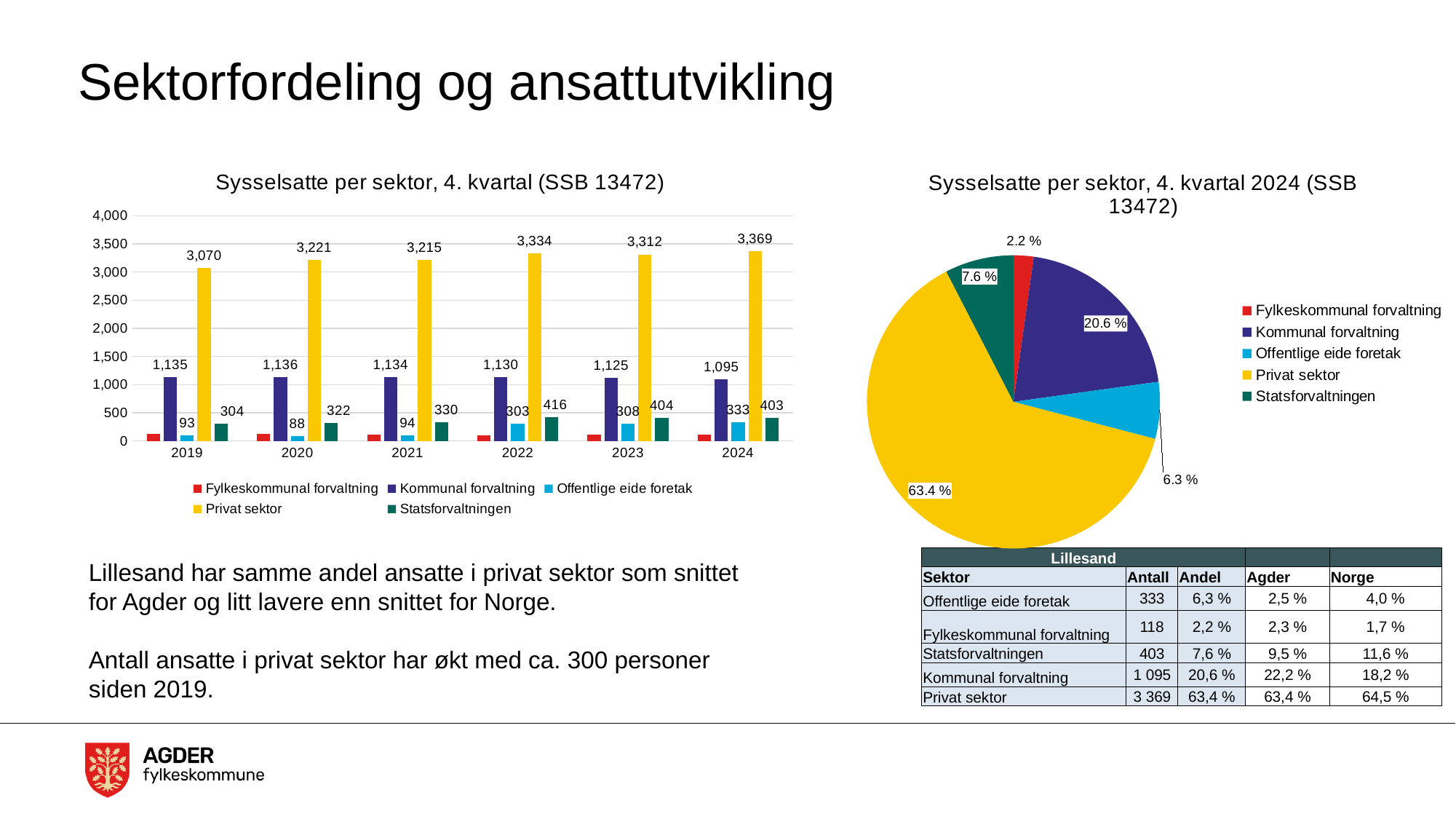
In the pie chart 'Sysselsatte per sektor, 4. kvartal 2024 (SSB 13472)', what share does Privat sektor have? 63.4 % In the bar chart on the left, what is the value for Offentlige eide foretak in 2021? 94 How many series does the legend of the bar chart on the left list? 5 In the bar chart 'Sysselsatte per sektor, 4. kvartal (SSB 13472)', what is the value for Privat sektor in 2024? 3,369 In the bar chart on the left, what is the value for Kommunal forvaltning in 2019? 1,135 In the bar chart on the left, which is larger in 2022: Statsforvaltningen or Offentlige eide foretak? Statsforvaltningen In the bar chart on the left, is the value for Fylkeskommunal forvaltning in 2024 greater or less than 500? less What kind of chart is the chart on the right of the slide? pie chart In the bar chart on the left, in which year is Privat sektor highest? 2024 In the bar chart on the left, what is the difference between Privat sektor in 2024 and in 2019? 299 How many years are shown on the x axis of the bar chart on the left? 6 In the bar chart on the left, in which year is Statsforvaltningen lowest? 2019